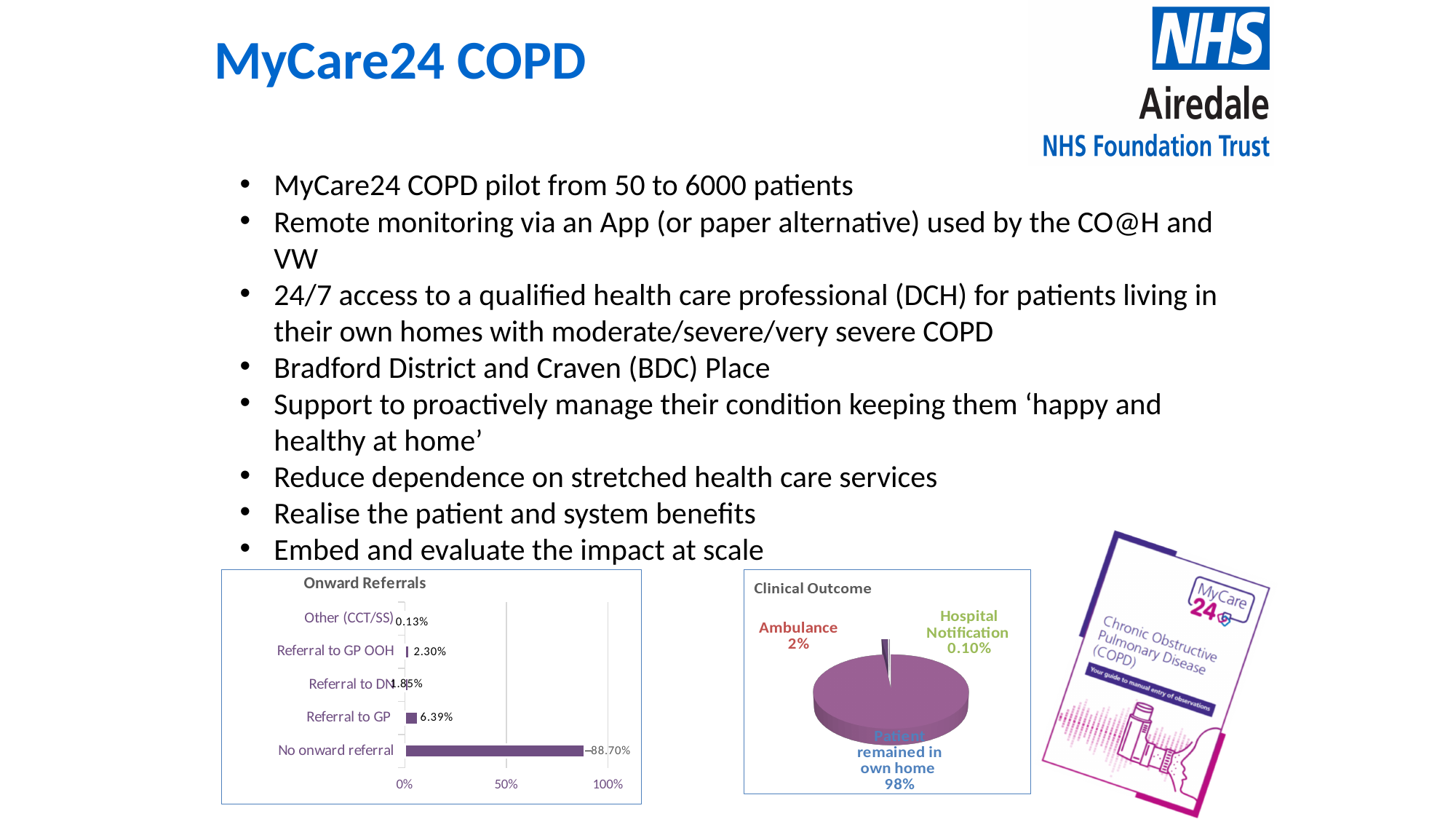
In the Clinical Outcome chart, what share of the pie is Patient remained in own home? 98% In the Onward Referrals chart, what is the value for Referral to GP? 6.39% What kind of chart is the Onward Referrals chart? Bar chart In the Clinical Outcome chart, what is the value for Ambulance? 2% In the Onward Referrals chart, what is the value for No onward referral? 88.70% In the Onward Referrals chart, what is the value for Referral to GP OOH? 2.30% In the Onward Referrals chart, how many categories are shown? 5 In the Clinical Outcome chart, which slice is the smallest? Hospital Notification In the Onward Referrals chart, is the value for No onward referral greater or less than 50%? greater In the Onward Referrals chart, which category has the highest value? No onward referral What kind of chart is the Clinical Outcome chart? Pie chart In the Onward Referrals chart, which category has the lowest value? Other (CCT/SS)